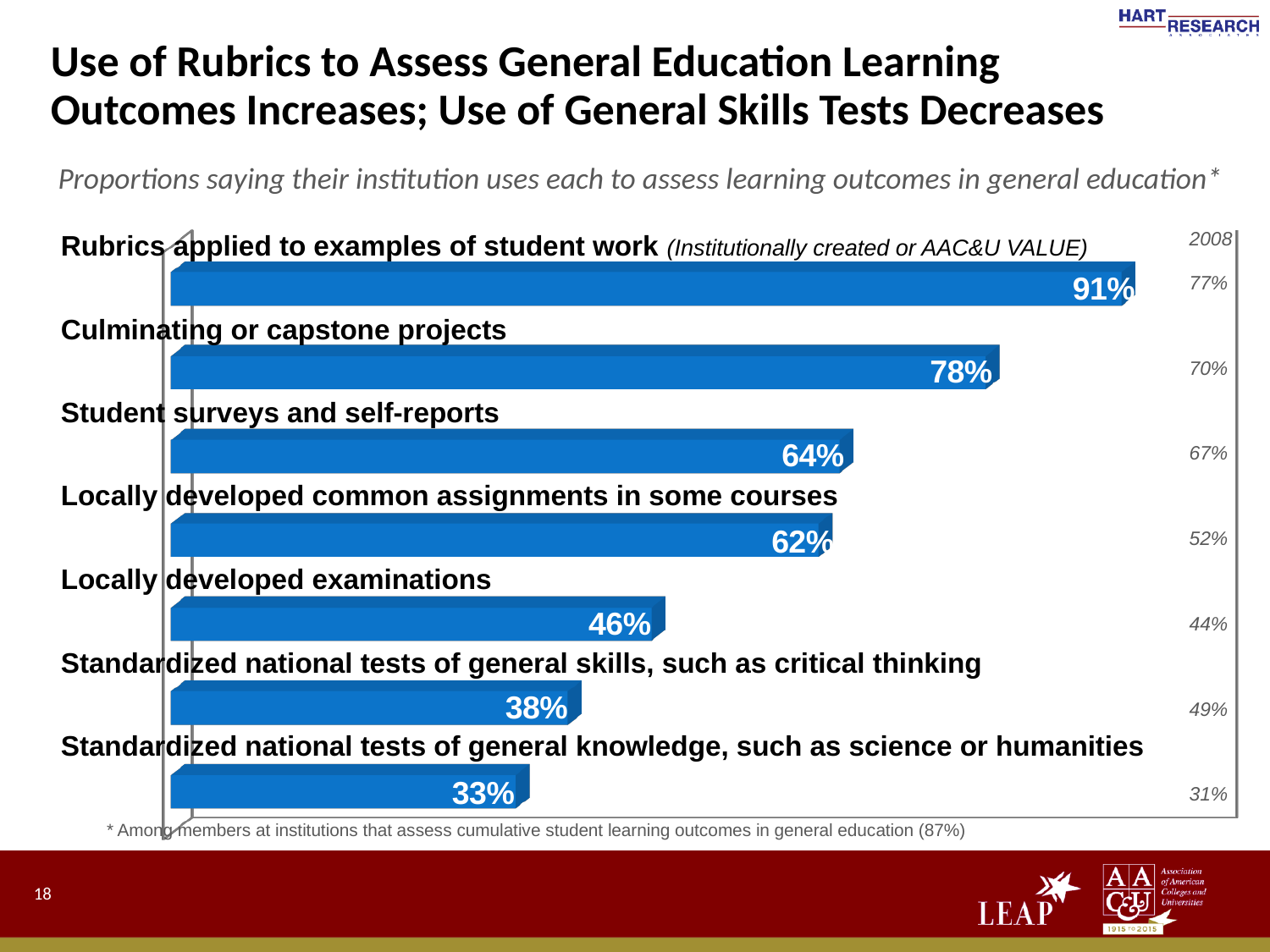
Which is larger: the value for locally developed examinations or the value for standardized national tests of general skills, such as critical thinking? Locally developed examinations How many assessment methods are shown as bars in the chart? 7 What is the value shown for culminating or capstone projects? 78% Which assessment method has the lowest percentage in the chart? Standardized national tests of general knowledge, such as science or humanities What kind of chart is shown on the slide? Bar chart Which assessment method has the highest percentage in the chart? Rubrics applied to examples of student work What is the difference between the percentages for student surveys and self-reports and locally developed common assignments in some courses? 2% What was the 2008 value listed for standardized national tests of general skills, such as critical thinking? 49% What percentage of respondents say their institution uses rubrics applied to examples of student work? 91% By how much did the percentage for rubrics applied to examples of student work change from the 2008 value of 77% to the current value? 14% What percentage is shown for standardized national tests of general knowledge, such as science or humanities? 33% What colour are the bars in the chart? Blue